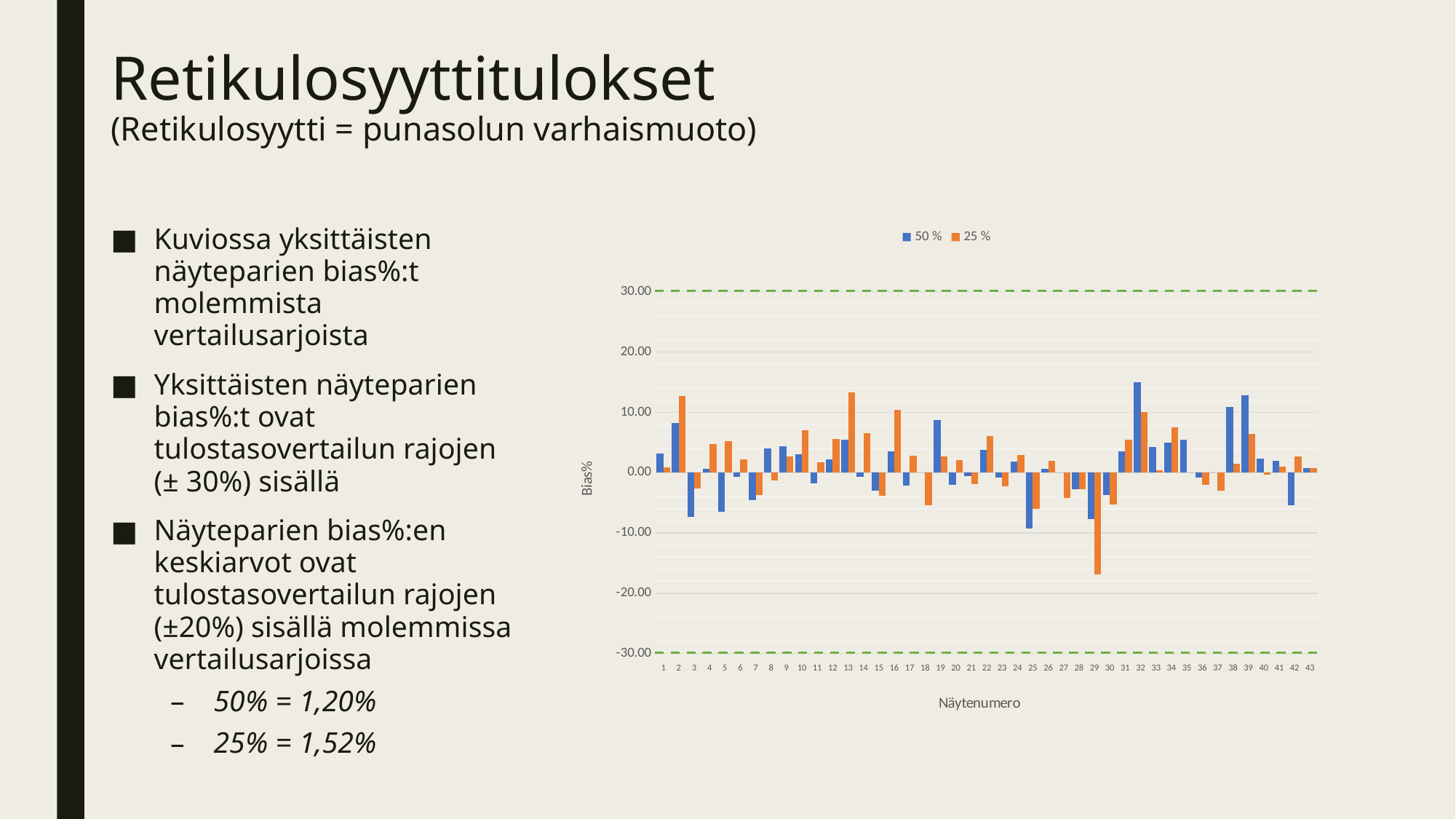
For sample 29, which series has the larger value, 50 % or 25 %? 50 % Which sample number has the highest value in the 50 % series? 32 How many series does the chart legend list? 2 Is the 25 % value for sample 13 greater or less than 10.00? greater For sample 2, which series has the larger value, 50 % or 25 %? 25 % Is the 25 % value for sample 29 greater or less than -10.00? less How many sample numbers (Näytenumero) are plotted along the x axis? 43 Which sample number has the lowest value in the 25 % series? 29 What is the title of the chart's vertical axis? Bias% Is the 50 % value for sample 32 greater or less than 10.00? greater What kind of chart is shown on the slide? Bar chart